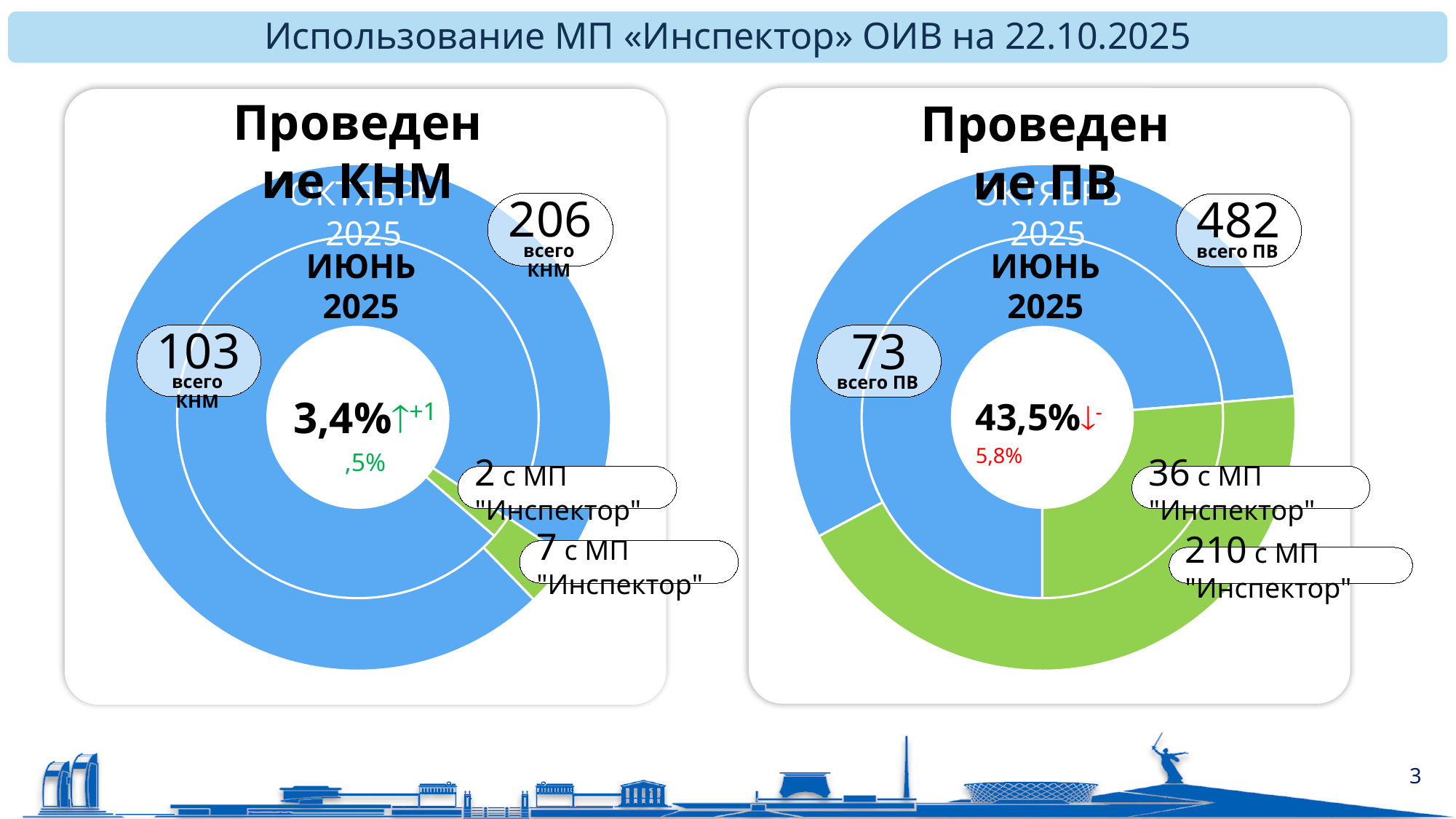
What kind of chart is used on the slide for "Проведение КНМ"? doughnut chart In the "Проведение КНМ" chart, what is the difference between the total КНМ in October 2025 and June 2025? 103 In the "Проведение ПВ" chart, which is larger: the number of ПВ with МП "Инспектор" in October 2025 or in June 2025? October 2025 In the "Проведение ПВ" chart, what is the total number of ПВ for October 2025? 482 What is the title of the slide? Использование МП «Инспектор» ОИВ на 22.10.2025 In the "Проведение ПВ" chart, how many ПВ were conducted with МП "Инспектор" in October 2025? 210 In the "Проведение КНМ" chart, what is the total number of КНМ for June 2025? 103 In the "Проведение ПВ" chart, how many ПВ were conducted with МП "Инспектор" in June 2025? 36 In the "Проведение КНМ" chart, what is the total number of КНМ for October 2025? 206 What percentage is shown in the centre of the "Проведение ПВ" chart? 43,5% In the "Проведение ПВ" chart, what is the difference between the total ПВ in October 2025 and June 2025? 409 In the "Проведение КНМ" chart, how many КНМ were conducted with МП "Инспектор" in October 2025? 7